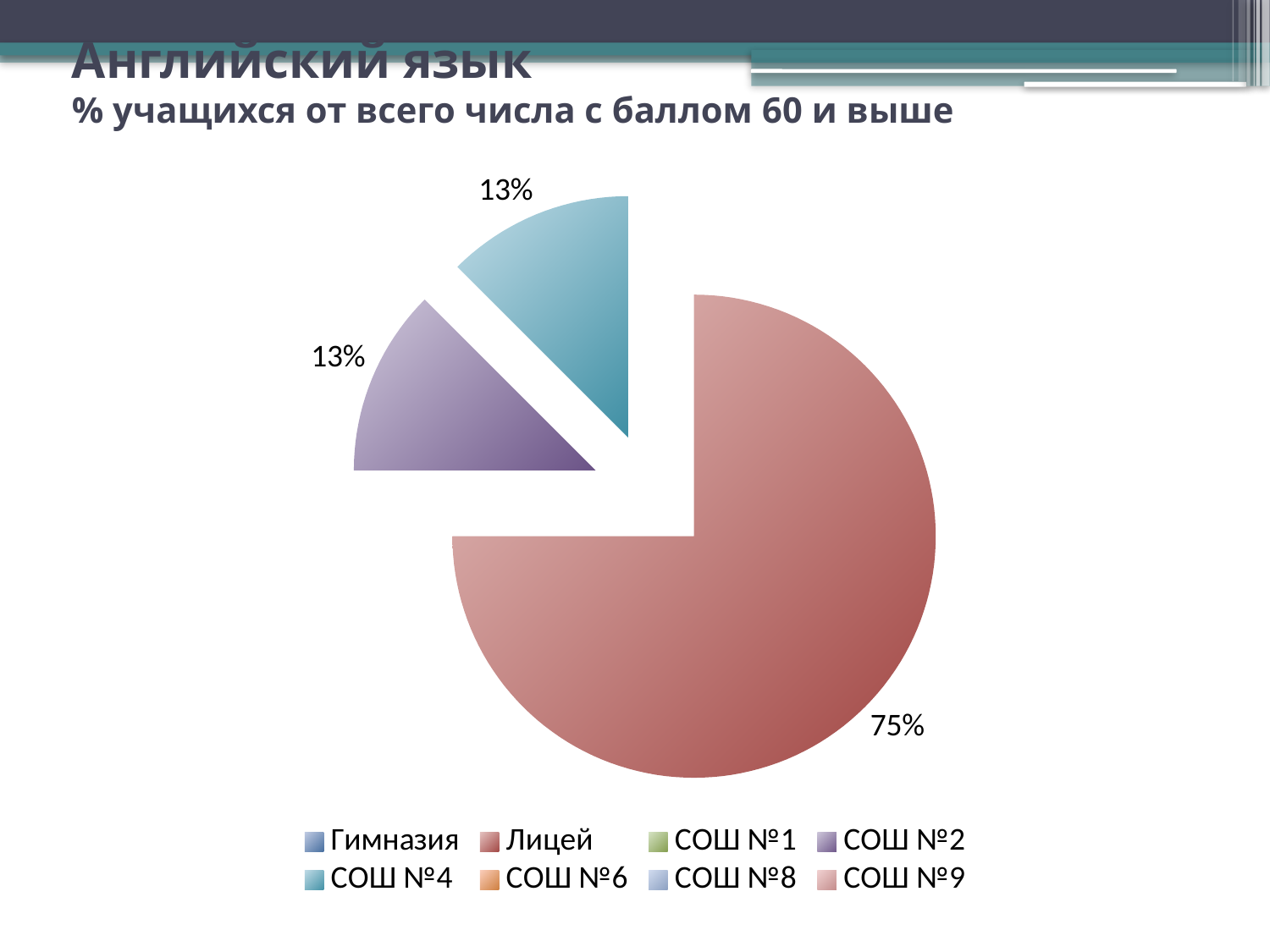
Which is larger, the slice for Лицей or the slice for СОШ №4? Лицей What is the difference in percentage points between the Лицей slice and the СОШ №2 slice? 62 What colour is the slice for СОШ №4? teal What percentage is shown for the largest slice of the pie? 75% Is the value for Лицей greater or less than 50%? greater What percentage is shown for СОШ №2? 13% How many entries does the legend list? 8 What kind of chart is shown on the slide? pie chart Which category has the largest slice of the pie? Лицей How many slices with data labels are visible in the pie? 3 What is the subtitle of the chart below 'Английский язык'? % учащихся от всего числа с баллом 60 и выше What percentage is shown for СОШ №4? 13%